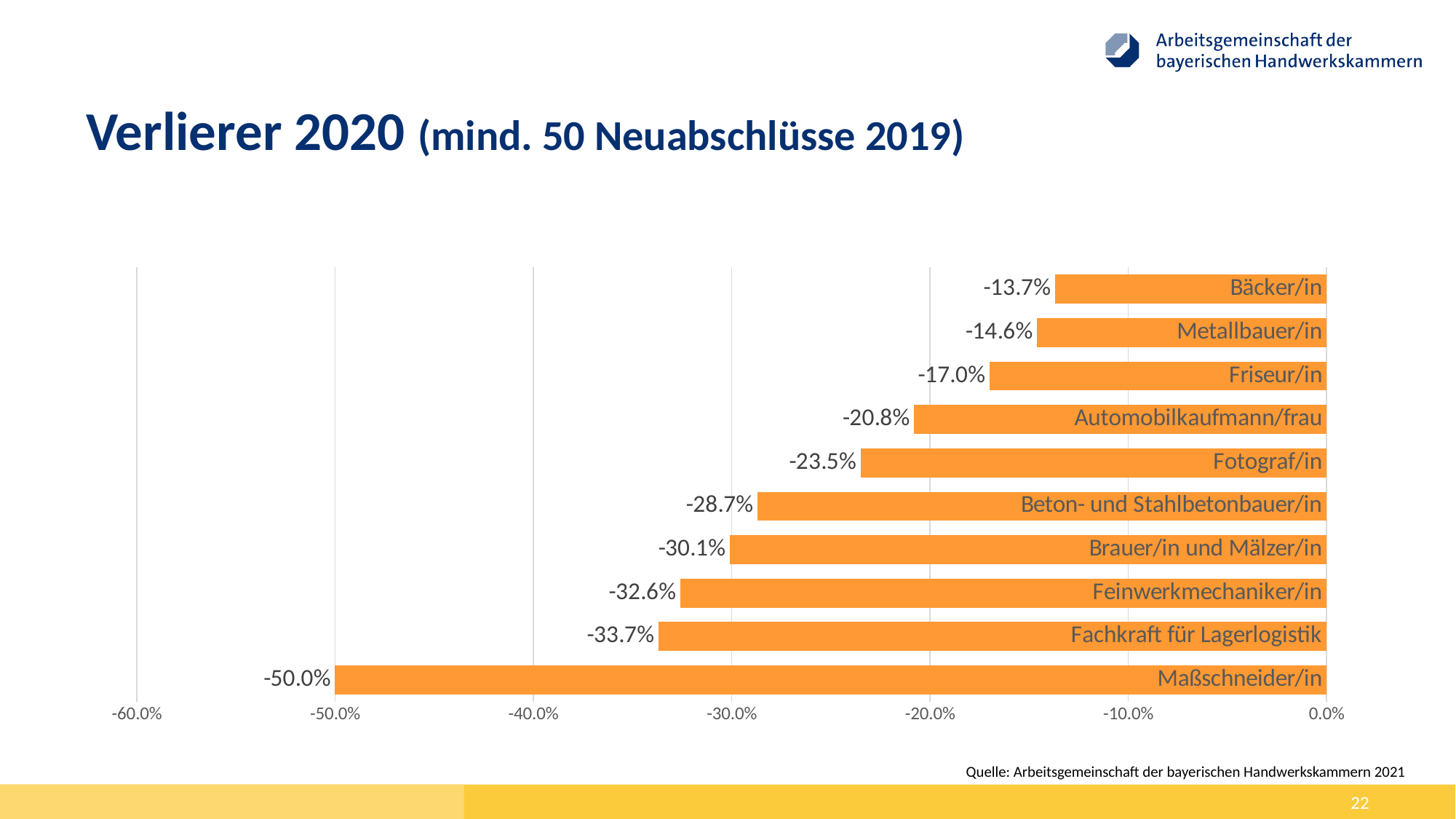
What is the difference between the values for Fachkraft für Lagerlogistik and Feinwerkmechaniker/in? 1.1 percentage points Which category has the lowest value (largest decline)? Maßschneider/in What is the value for Fotograf/in? -23.5% What is the value for Metallbauer/in? -14.6% What is the value for Brauer/in und Mälzer/in? -30.1% Which category has the highest value (smallest decline)? Bäcker/in What is the title of the slide containing the chart? Verlierer 2020 (mind. 50 Neuabschlüsse 2019) Which has the larger decline, Friseur/in or Automobilkaufmann/frau? Automobilkaufmann/frau Is the value for Beton- und Stahlbetonbauer/in greater or less than -30.0%? greater What kind of chart is shown on the slide? Bar chart How many categories are shown in the chart? 10 What is the value for Maßschneider/in? -50.0%